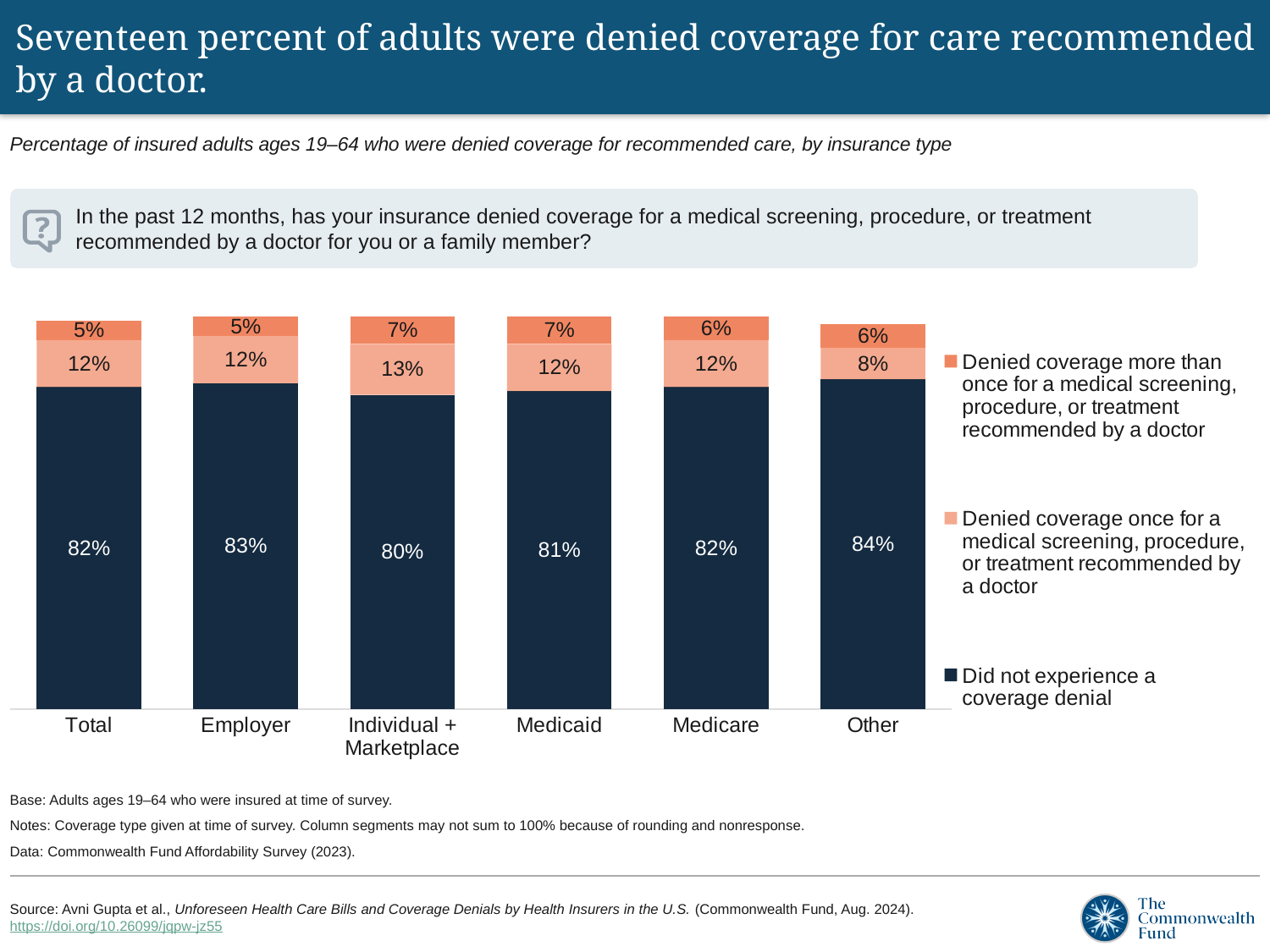
What kind of chart is shown on the slide? Stacked bar chart How many series does the legend list? 3 What percentage of adults with Other coverage were denied coverage once for a medical screening, procedure, or treatment recommended by a doctor? 8% How many insurance type categories are shown on the x axis? 6 Which is larger: the percentage denied coverage once for Individual + Marketplace or for Other? Individual + Marketplace What percentage of adults with Medicaid were denied coverage more than once for a medical screening, procedure, or treatment recommended by a doctor? 7% What is the difference between the percentage of adults with Other coverage and adults with Individual + Marketplace coverage who did not experience a coverage denial? 4% Which legend entry is shown in dark navy? Did not experience a coverage denial What percentage of adults with Employer coverage did not experience a coverage denial? 83% Which insurance type has the highest percentage of adults who did not experience a coverage denial? Other What is the sum of the three segments of the Total bar? 99% Which insurance type has the lowest percentage of adults who did not experience a coverage denial? Individual + Marketplace